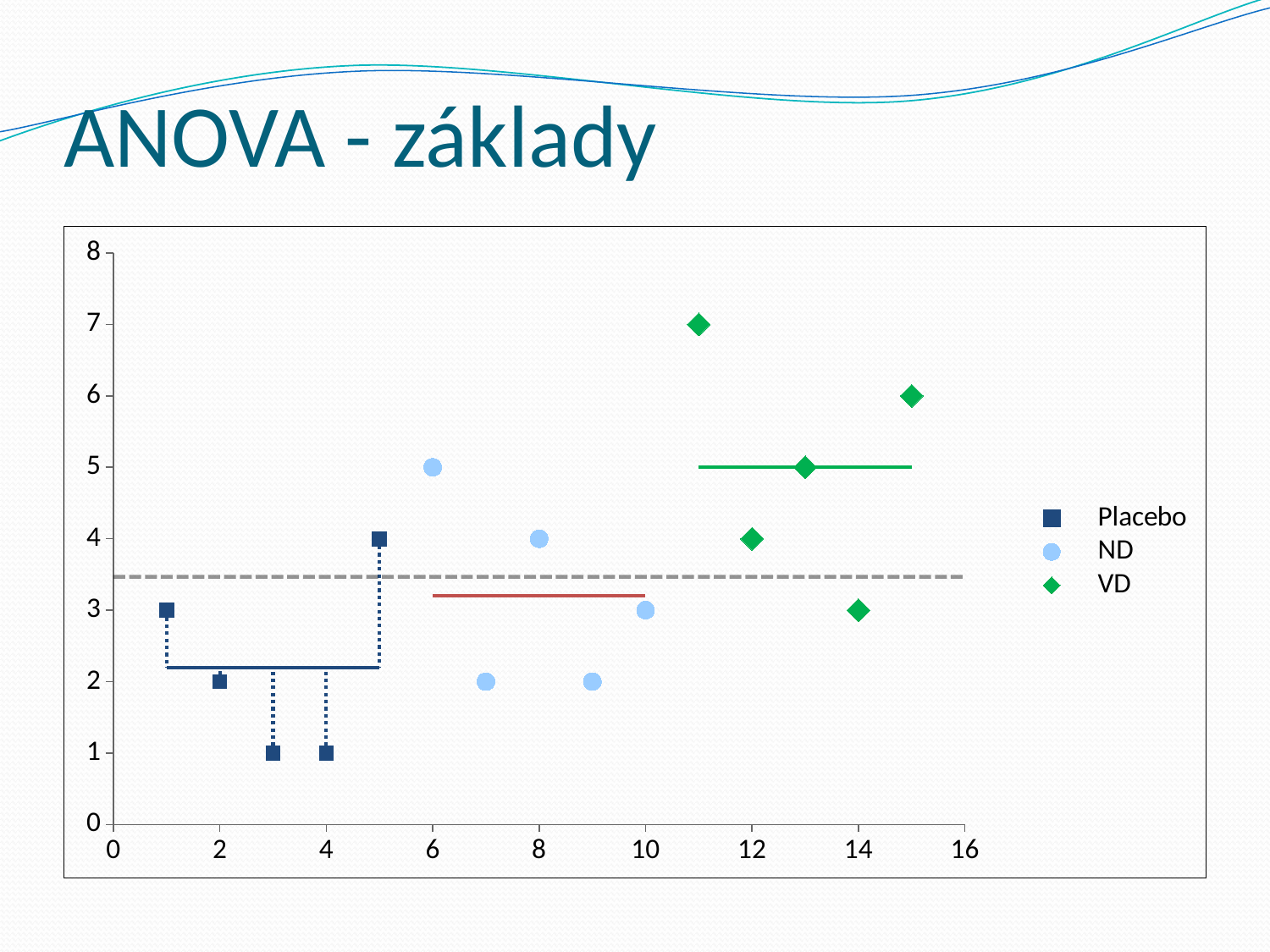
What are the names of the series in the legend? Placebo, ND, VD What is the y value of the VD point at x = 11? 7 Which series contains the highest point on the chart? VD What is the lowest y value plotted on the chart? 1 What is the y value of the VD point at x = 14? 3 Which is larger: the ND point at x = 8 or the Placebo point at x = 2? the ND point at x = 8 What is the y value of the Placebo point at x = 5? 4 What is the difference between the VD point at x = 11 and the Placebo point at x = 3? 6 What is the y value of the ND point at x = 6? 5 How many data points does the Placebo series have? 5 How many series does the legend list? 3 What kind of chart is shown on the slide? scatter chart